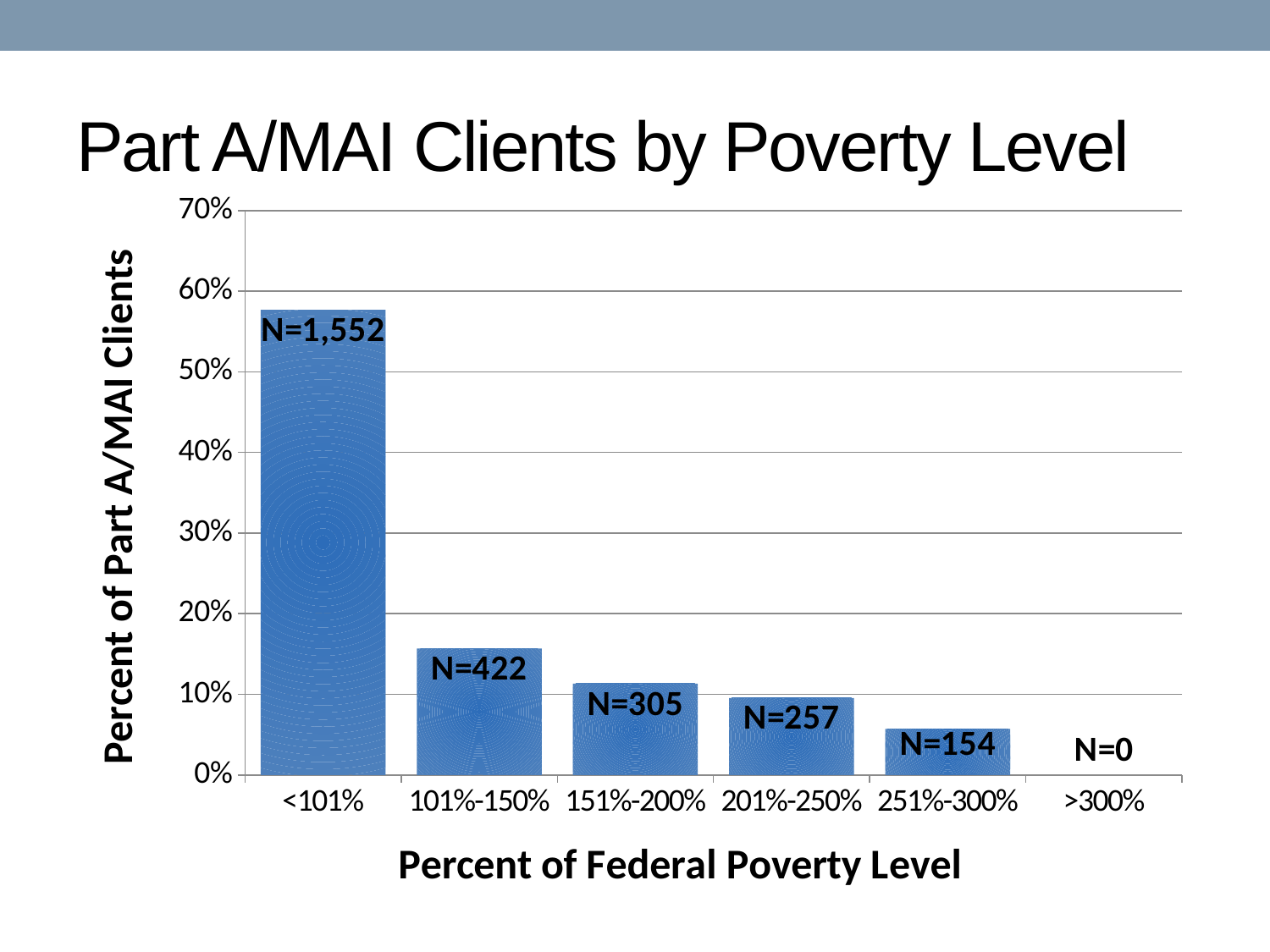
What is the N value labelled on the bar for the <101% poverty level category? N=1,552 What kind of chart is shown on the slide? bar chart Which poverty level category has the lowest percent of Part A/MAI clients? >300% What is the N value labelled for the 251%-300% category? N=154 What is the N value labelled for the 101%-150% category? N=422 What is the difference between the N values for the 151%-200% and 201%-250% categories? 48 Is the percent of Part A/MAI clients for the 101%-150% category greater or less than 20%? less How many poverty level categories are shown on the x axis? 6 Which poverty level category has the highest percent of Part A/MAI clients? <101% Is the percent of Part A/MAI clients for the <101% category greater or less than 50%? greater What is the N value labelled for the >300% category? N=0 What is the title of the chart? Part A/MAI Clients by Poverty Level